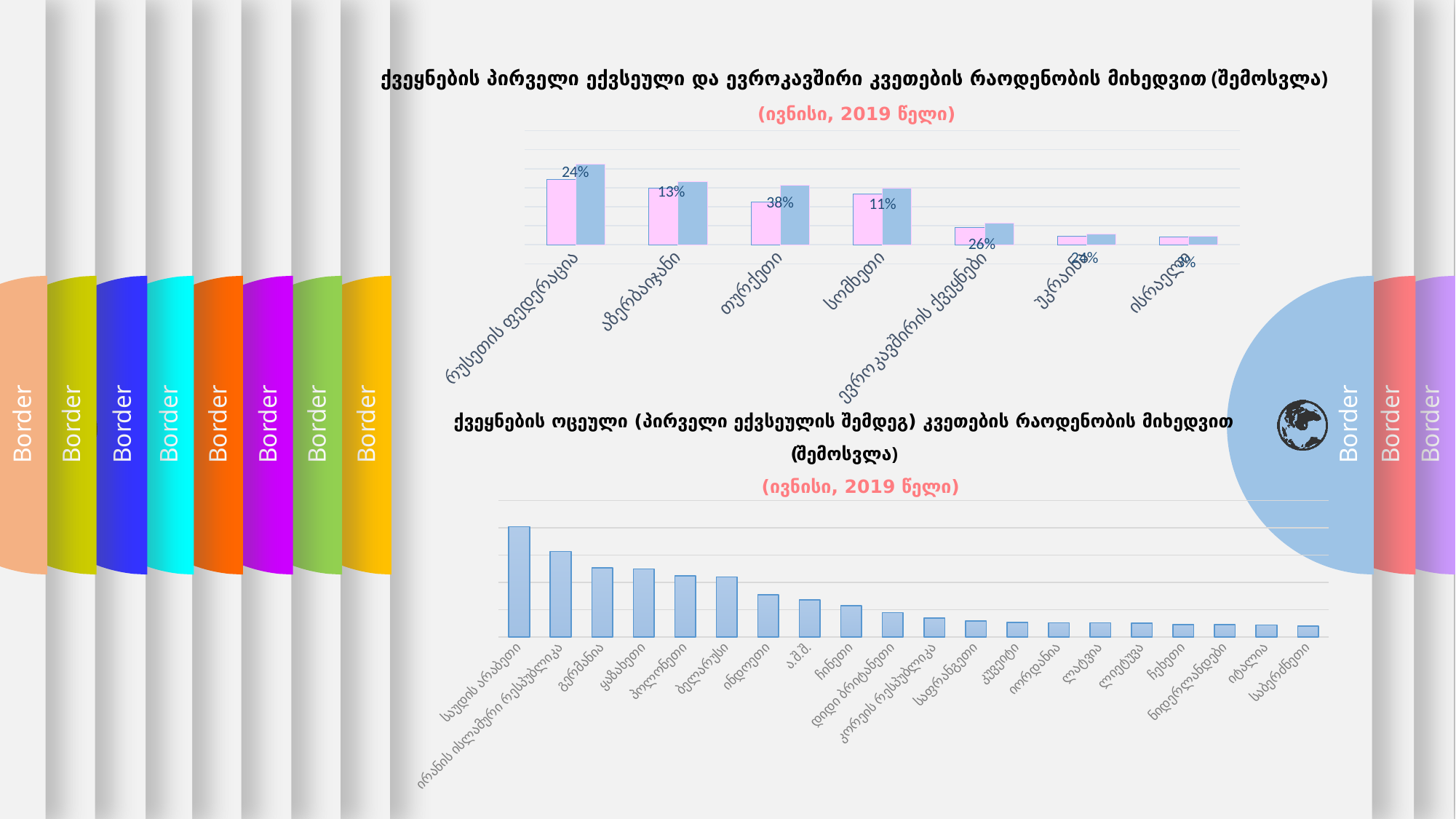
In the top chart, what percentage label is printed at the bars for თურქეთი? 38% What year is given in the subtitle of the top chart? 2019 In the top chart, what percentage label is printed at the bars for რუსეთის ფედერაცია? 24% In the top chart, which has taller bars: რუსეთის ფედერაცია or აზერბაიჯანი? რუსეთის ფედერაცია How many countries/categories are shown on the x axis of the top chart? 7 In the top chart, which category has the tallest bars? რუსეთის ფედერაცია In the top chart, which has taller bars: აზერბაიჯანი or ევროკავშირის ქვეყნები? აზერბაიჯანი In the bottom chart, which country has the tallest bar? საუდის არაბეთი How many countries are shown on the x axis of the bottom chart? 20 What kind of chart is the bottom chart on the slide? bar chart In the bottom chart, do the bar values rise or fall from left to right along the x axis? fall What kind of chart is the top chart on the slide? bar chart